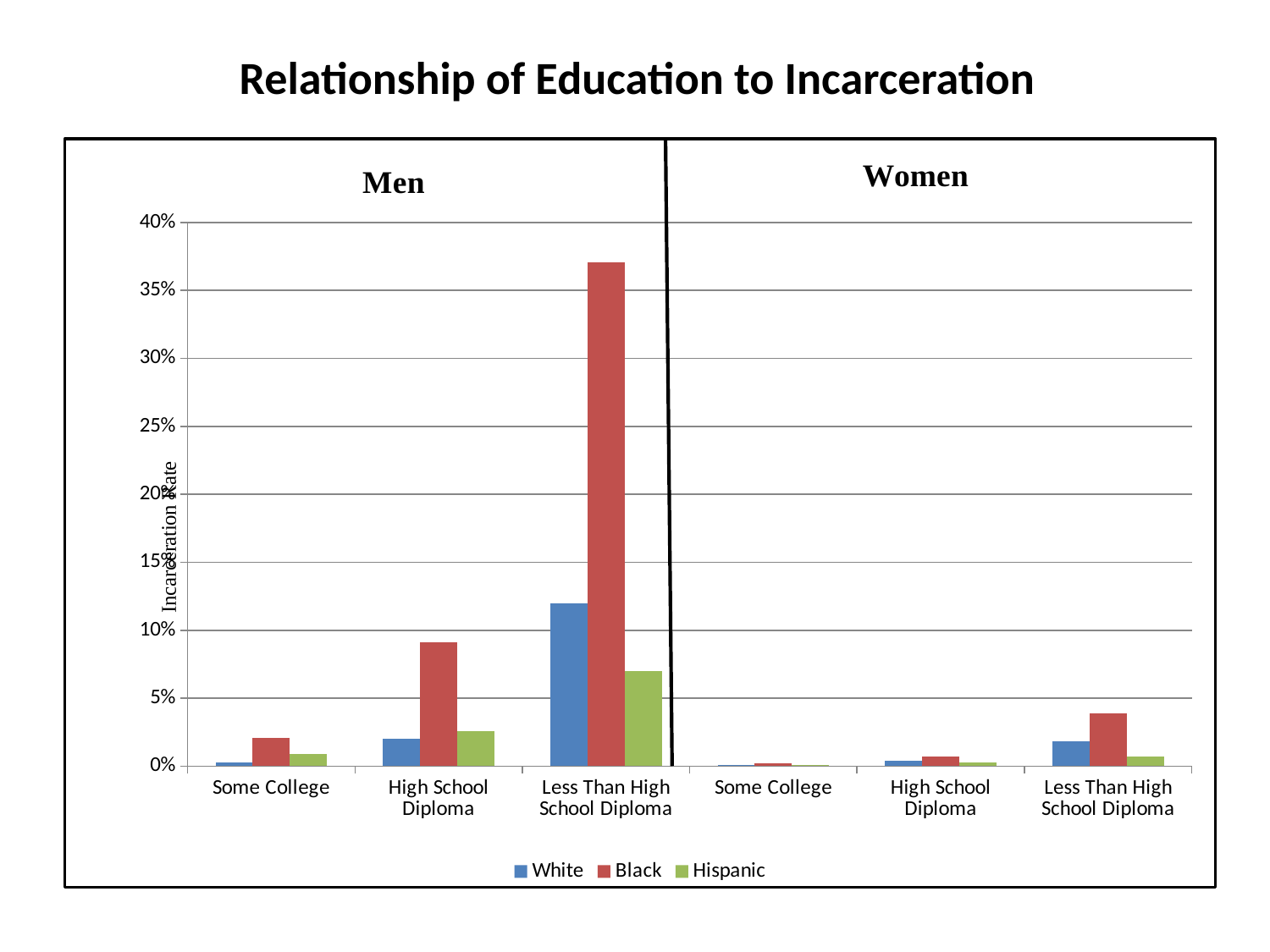
How many education categories are shown along the x axis in total (across Men and Women)? 6 Among men with Less Than High School Diploma, which is larger: the White bar or the Hispanic bar? White Is the value for White men with Less Than High School Diploma greater or less than 10%? greater How many series does the legend list? 3 For Black men, do the values rise or fall moving from Some College to Less Than High School Diploma? rise What colour represents the Black series in the legend? red Is the value for Black men with Less Than High School Diploma greater or less than 35%? greater What is the label on the y axis? Incarceration Rate Among women with Less Than High School Diploma, which is larger: the Black bar or the White bar? Black Is the value for Black men with a High School Diploma greater or less than 10%? less Which series and category has the tallest bar on the chart? Black, Less Than High School Diploma (Men) What kind of chart is shown on the slide? bar chart